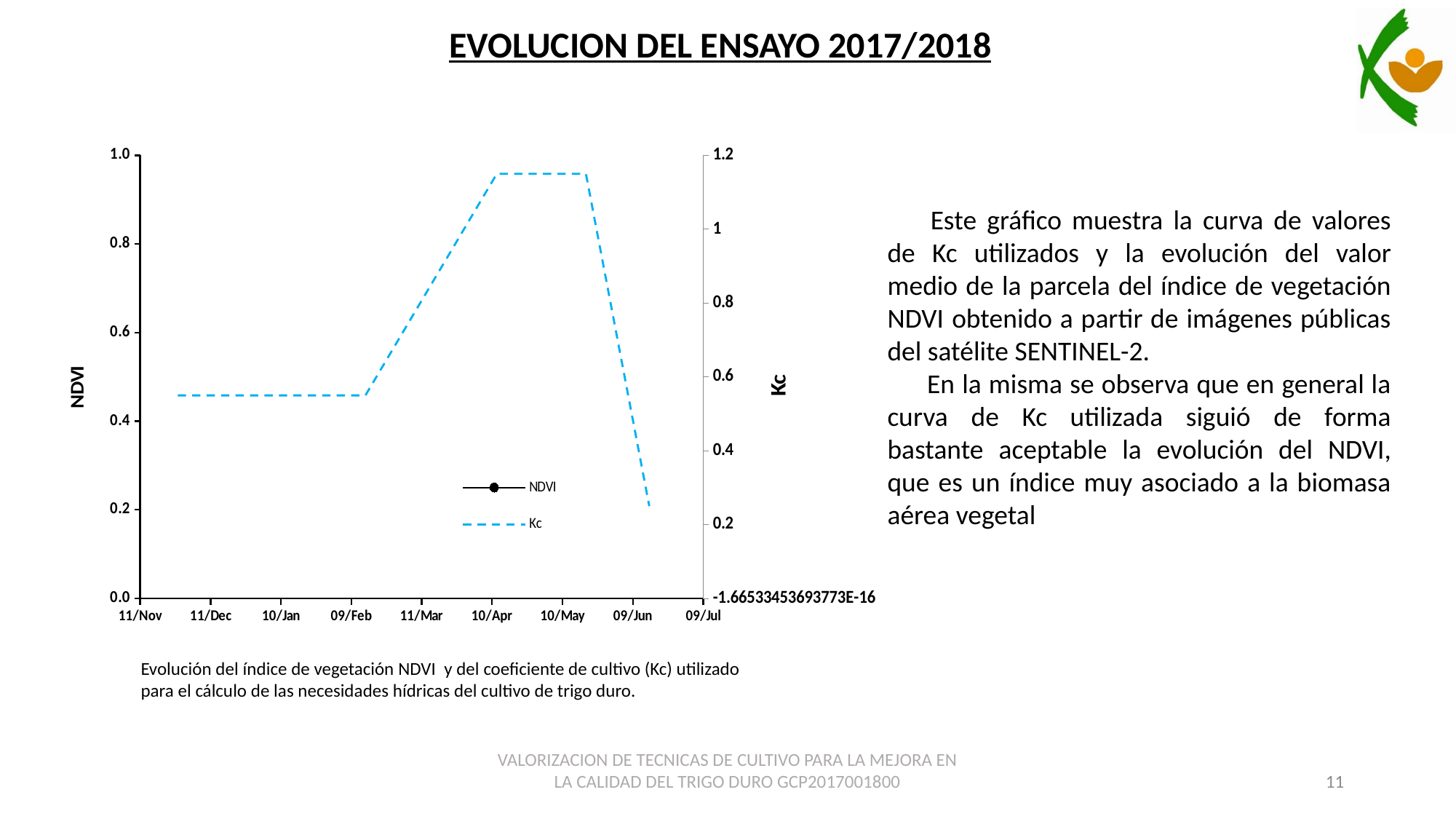
What are the two series named in the chart legend? NDVI and Kc Is the Kc value at 10/Apr greater or less than 1? greater What is the title of the right-hand vertical axis of the chart? Kc Is the Kc value at 09/Jun greater or less than 0.8? less How many series does the chart legend list? 2 How many date labels are shown along the x axis of the chart? 9 Is the Kc value at 11/Dec greater or less than 0.8? less Does the Kc line rise or fall between 10/May and 09/Jun? fall Is the Kc value higher at 10/Apr or at 11/Dec? 10/Apr Does the Kc line rise or fall between 09/Feb and 10/Apr? rise What kind of chart is shown on the slide? line chart